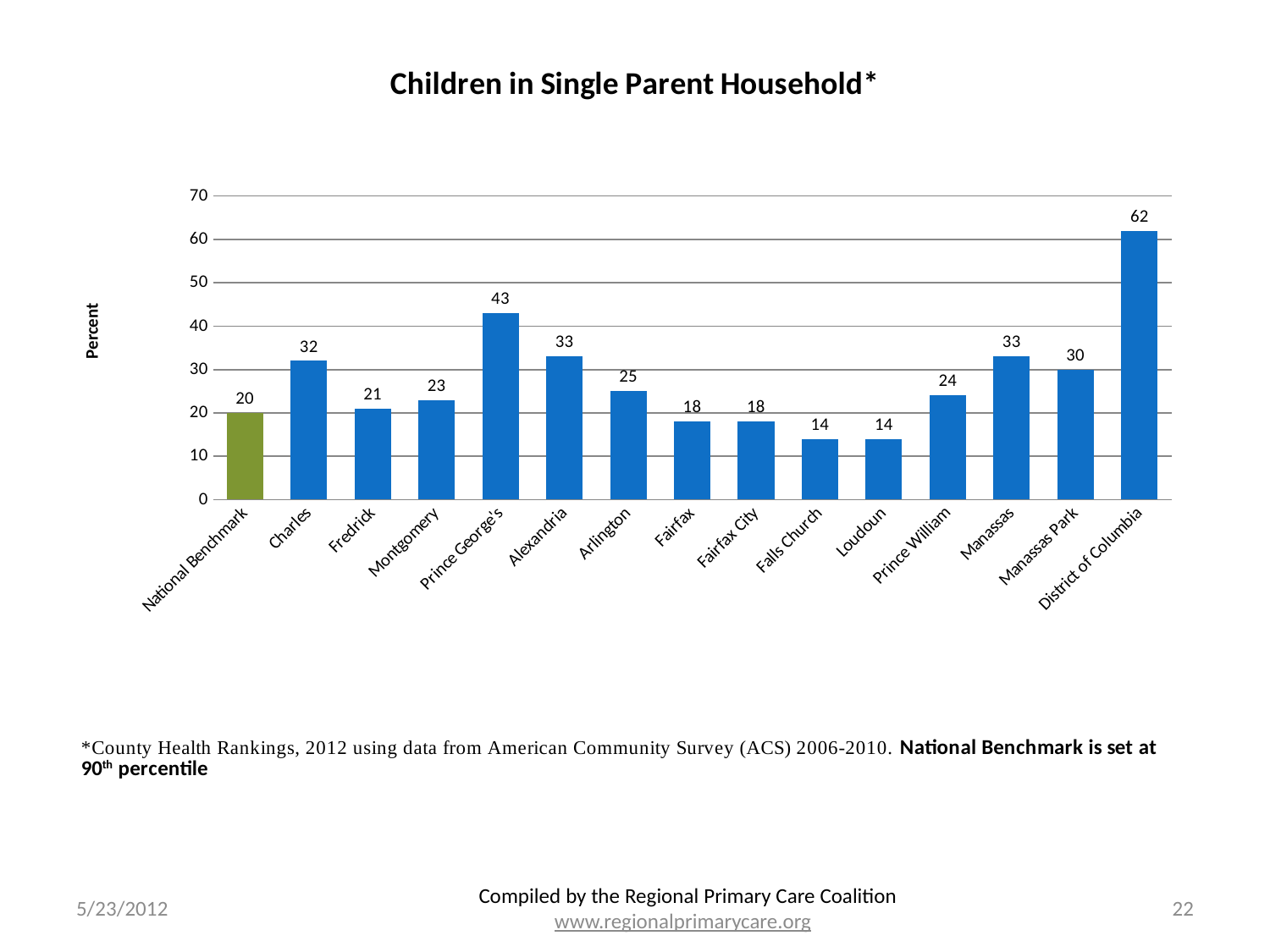
How many categories are shown on the x axis? 15 Which is larger, the value for Charles or the value for Arlington? Charles What kind of chart is shown? bar chart What is the value for Prince George's? 43 What is the value for Manassas Park? 30 Which category has the highest value? District of Columbia Is the value for Alexandria greater or less than 30? greater What is the title of the chart? Children in Single Parent Household* What is the value for the National Benchmark? 20 What is the difference between the values for District of Columbia and Prince George's? 19 Which categories have the lowest value? Falls Church and Loudoun Which bar is coloured green rather than blue? National Benchmark